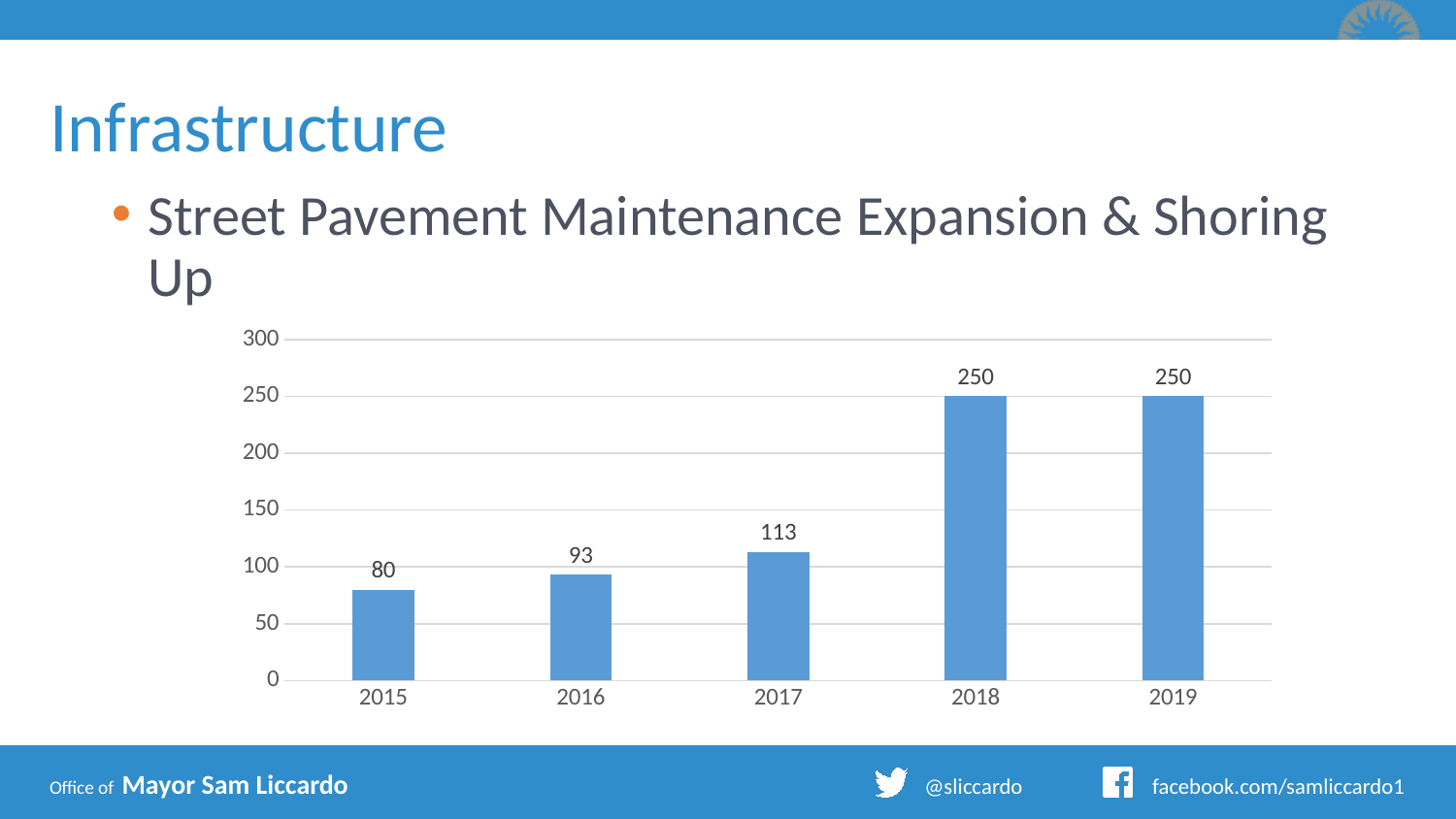
Do the values rise or fall from 2015 to 2018? rise What kind of chart is shown on the slide? bar chart Which is larger, the value for 2016 or the value for 2017? 2017 Is the value for 2016 greater or less than 100? less What is the difference between the values for 2016 and 2015? 13 Which year has the lowest value? 2015 What is the value for 2017? 113 What is the value for 2015? 80 What is the difference between the values for 2018 and 2017? 137 Is the value for 2018 greater or less than 200? greater What is the value for 2019? 250 How many years are shown on the x axis? 5